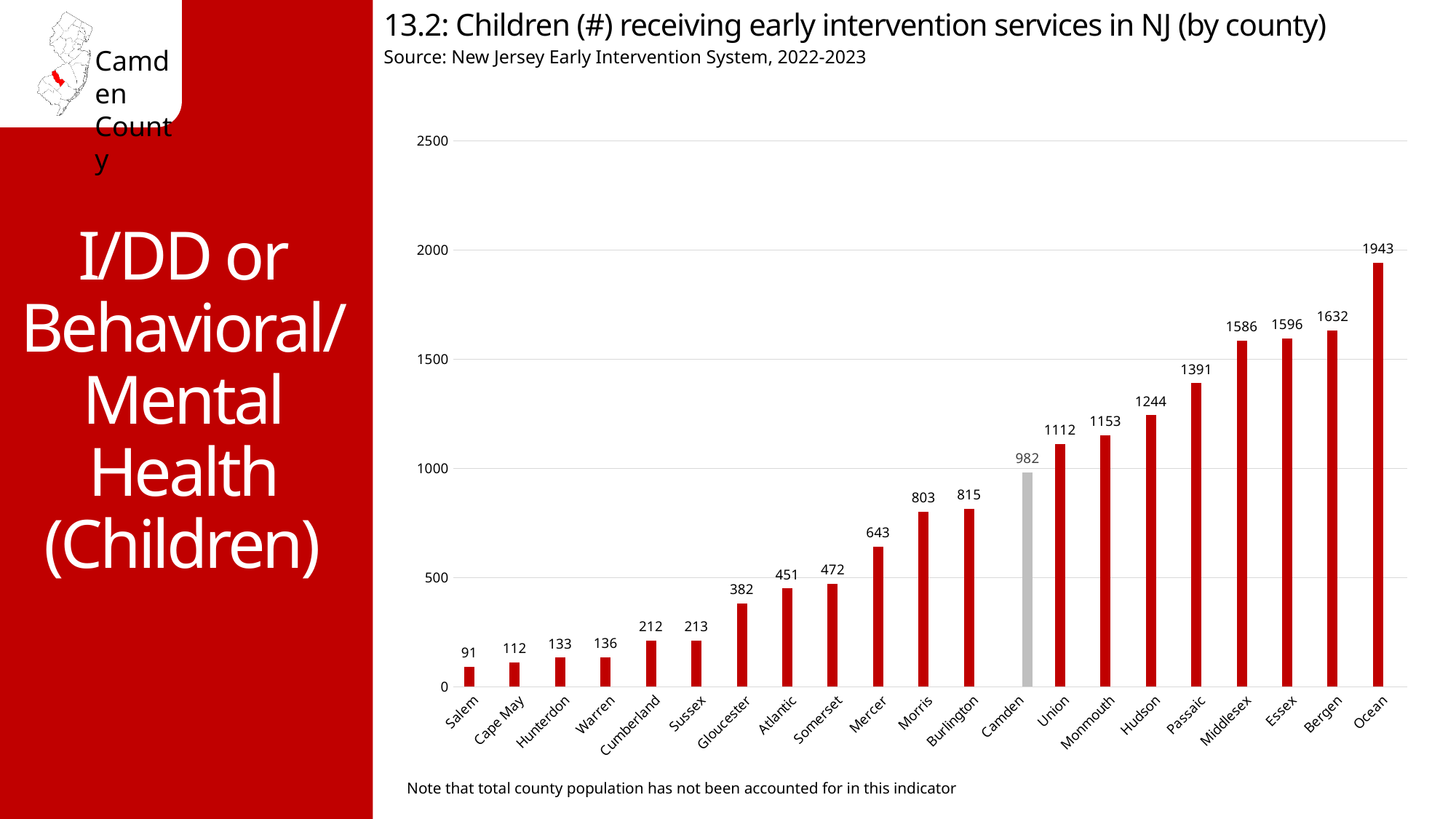
Which county has the lowest number of children receiving early intervention services? Salem What is the difference between the values for Ocean and Camden? 961 Which county has a larger value, Mercer or Burlington? Burlington Is the value for Hudson greater or less than 1000? greater Which county has the highest number of children receiving early intervention services? Ocean What is the value shown for Gloucester county? 382 What is the value shown for Ocean county? 1943 Which county's bar is coloured grey instead of red? Camden How many counties are shown on the x axis of the chart? 21 What is the difference between the values for Bergen and Essex? 36 What kind of chart is shown on the slide? Bar chart How many children receiving early intervention services are shown for Camden? 982